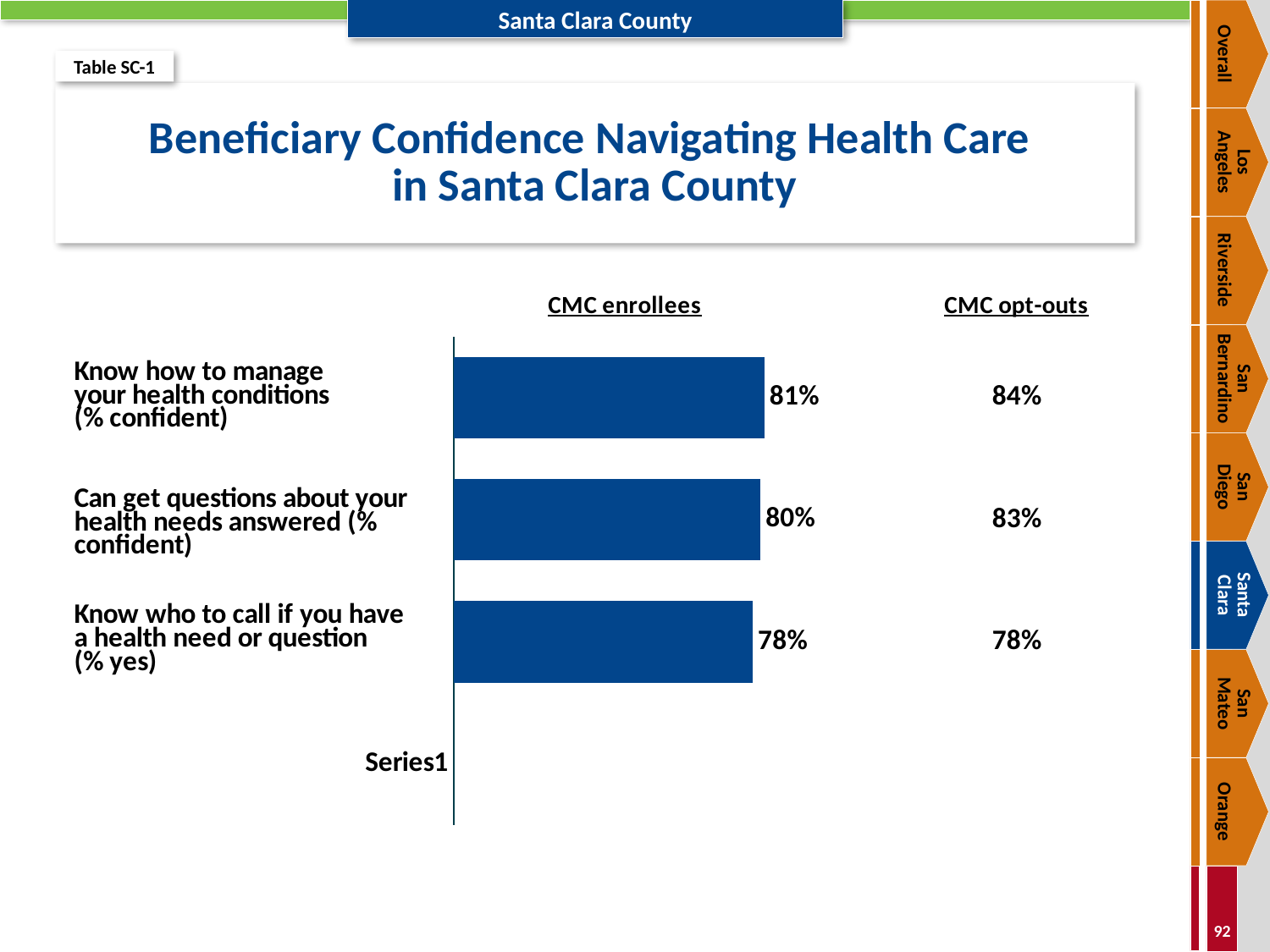
How many bars are plotted in the chart? 3 What is the title of the chart? Beneficiary Confidence Navigating Health Care in Santa Clara County What is the difference between the CMC enrollees values for "Know how to manage your health conditions" and "Know who to call if you have a health need or question"? 3 percentage points What is the CMC enrollees value for "Can get questions about your health needs answered (% confident)"? 80% What is the CMC enrollees value for "Know how to manage your health conditions (% confident)"? 81% What is the CMC opt-outs value shown for "Know how to manage your health conditions (% confident)"? 84% What is the CMC enrollees value for "Know who to call if you have a health need or question (% yes)"? 78% Which item has the highest CMC enrollees bar? Know how to manage your health conditions (% confident) What type of chart is shown on the slide? Bar chart What are the two column headings shown above the values? CMC enrollees and CMC opt-outs For "Can get questions about your health needs answered", which is larger: the CMC enrollees value or the CMC opt-outs value? CMC opt-outs Which item has the lowest CMC enrollees bar? Know who to call if you have a health need or question (% yes)